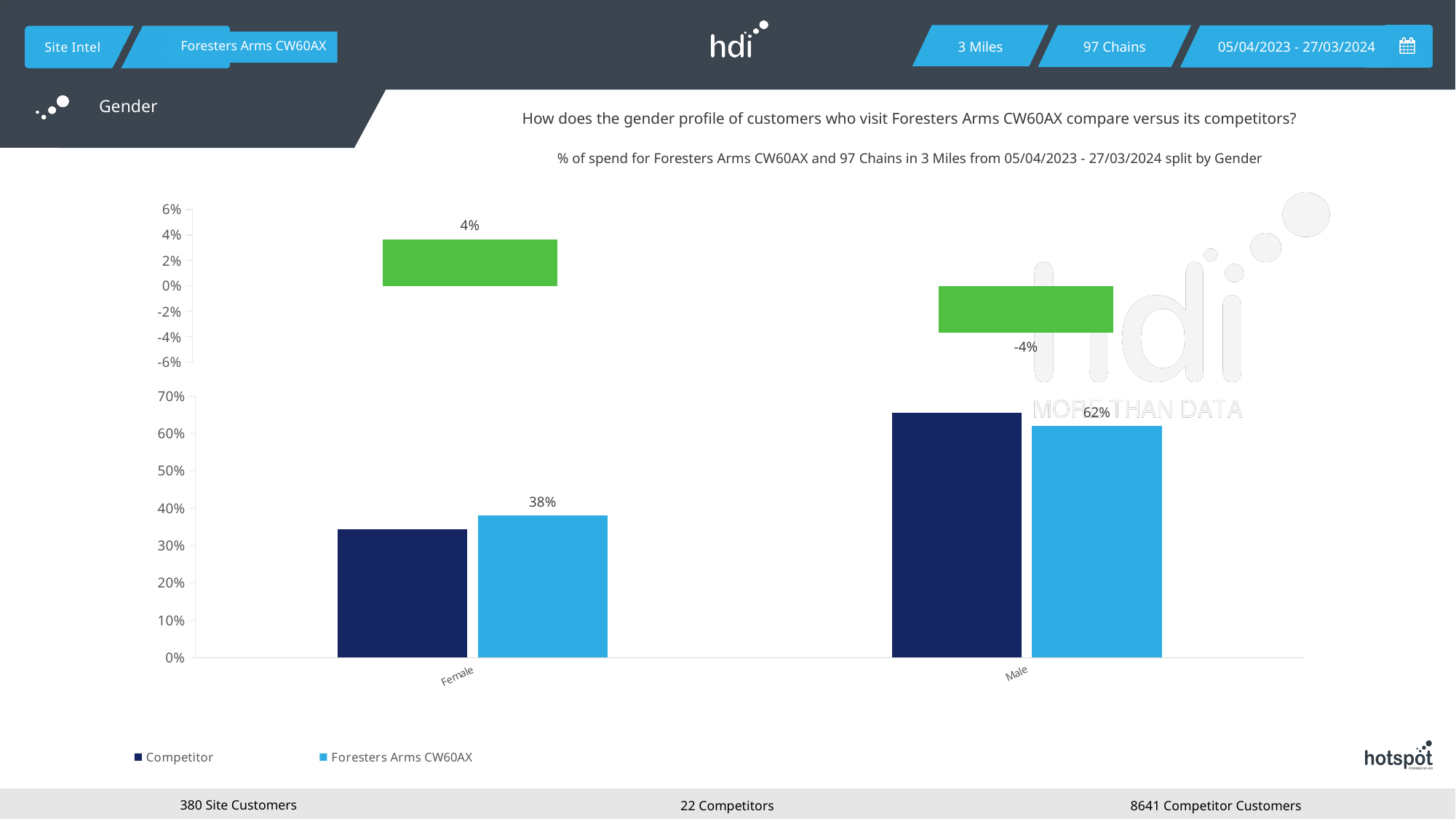
In the bottom bar chart, what is the difference between the Foresters Arms CW60AX values for Male and Female? 24% In the top difference chart, what is the value shown for Male? -4% In the bottom bar chart, for Male, which is larger: the Competitor bar or the Foresters Arms CW60AX bar? Competitor In the bottom bar chart, for Female, which is larger: the Competitor bar or the Foresters Arms CW60AX bar? Foresters Arms CW60AX In the bottom bar chart, what is the value for Foresters Arms CW60AX for Female? 38% In the bottom bar chart, is the Competitor value for Male greater or less than 60%? greater How many series does the legend of the bottom bar chart list? 2 In the bottom bar chart, what is the value for Foresters Arms CW60AX for Male? 62% What type of chart is the bottom chart on the slide? Bar chart In the bottom bar chart, is the Competitor value for Female greater or less than 40%? less In the top difference chart, what is the value shown for Female? 4% In the bottom bar chart, which gender has the higher value for Foresters Arms CW60AX? Male